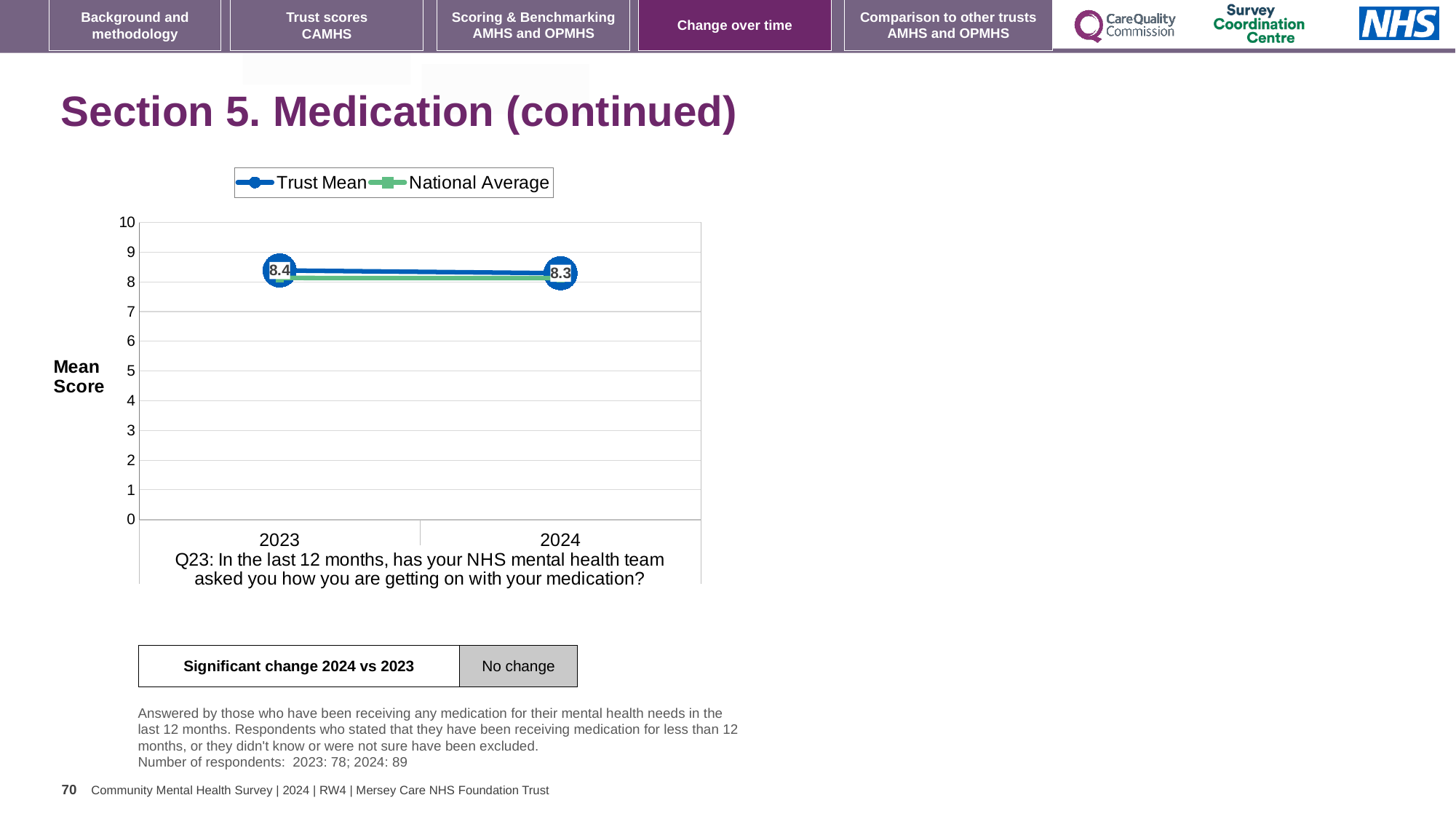
Does the Trust Mean rise or fall from 2023 to 2024? fall Which year has the higher Trust Mean, 2023 or 2024? 2023 How many series does the legend list? 2 Is the National Average value for 2024 greater or less than 5? greater In 2023, which is higher, the Trust Mean or the National Average? Trust Mean What is the Trust Mean value for 2023? 8.4 What is the difference between the Trust Mean in 2023 and in 2024? 0.1 What are the two series named in the legend? Trust Mean and National Average How many years are shown on the x axis? 2 What is the Trust Mean value for 2024? 8.3 What kind of chart is shown on the slide? line chart What is the label on the y axis of the chart? Mean Score